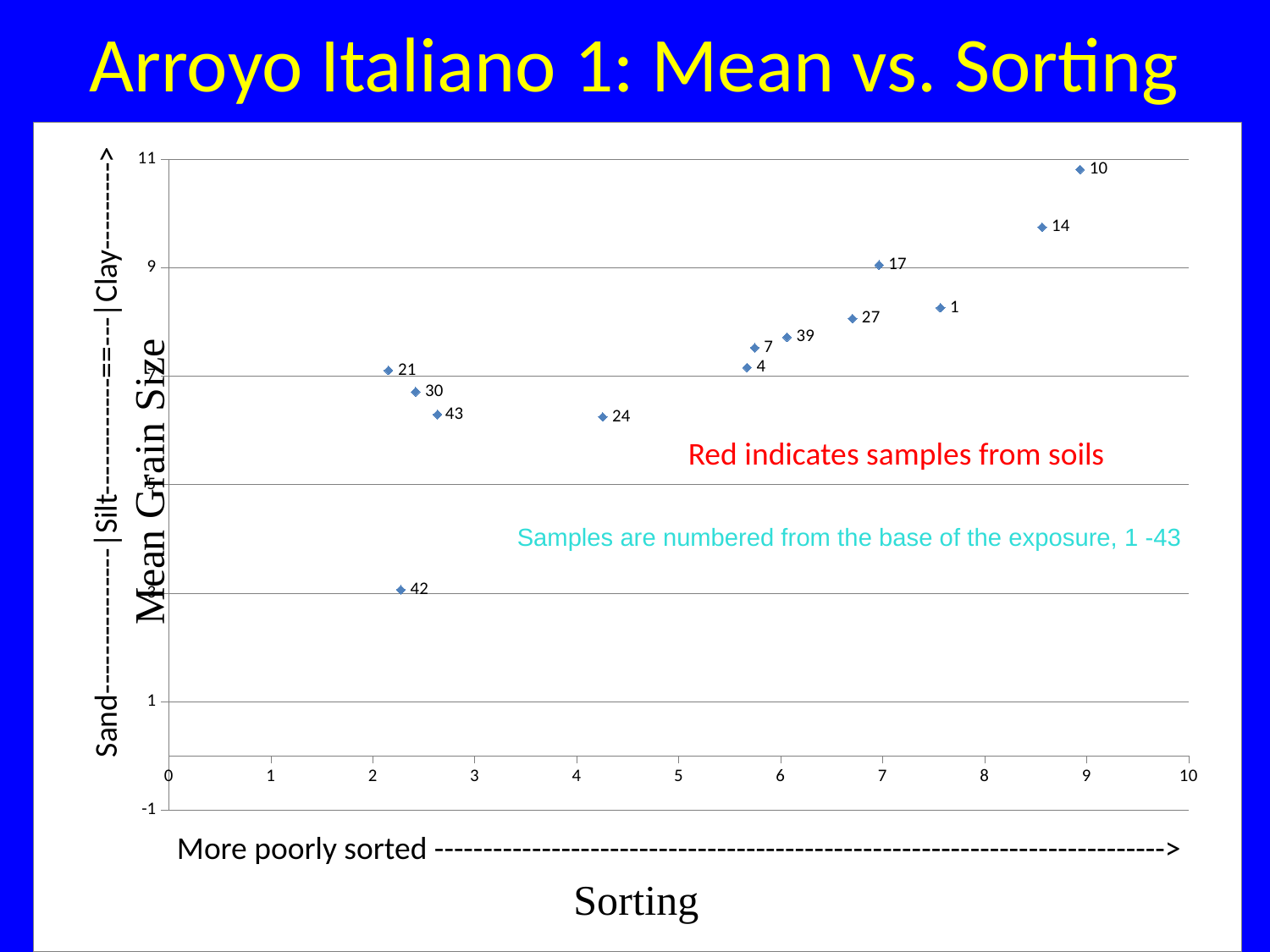
Which sample has the lowest mean grain size? 42 What kind of chart is shown on the slide? scatter chart How many sample points are plotted on the chart? 13 As sorting increases along the x axis, does mean grain size generally rise or fall? rise Is the mean grain size for sample 42 greater or less than 5? less Which sample has the highest mean grain size? 10 Is the sorting value for sample 21 greater or less than 3? less What is the title of the x axis? Sorting Which sample has the highest sorting value? 10 Is the mean grain size for sample 10 greater or less than 9? greater Which has the larger mean grain size, sample 14 or sample 24? sample 14